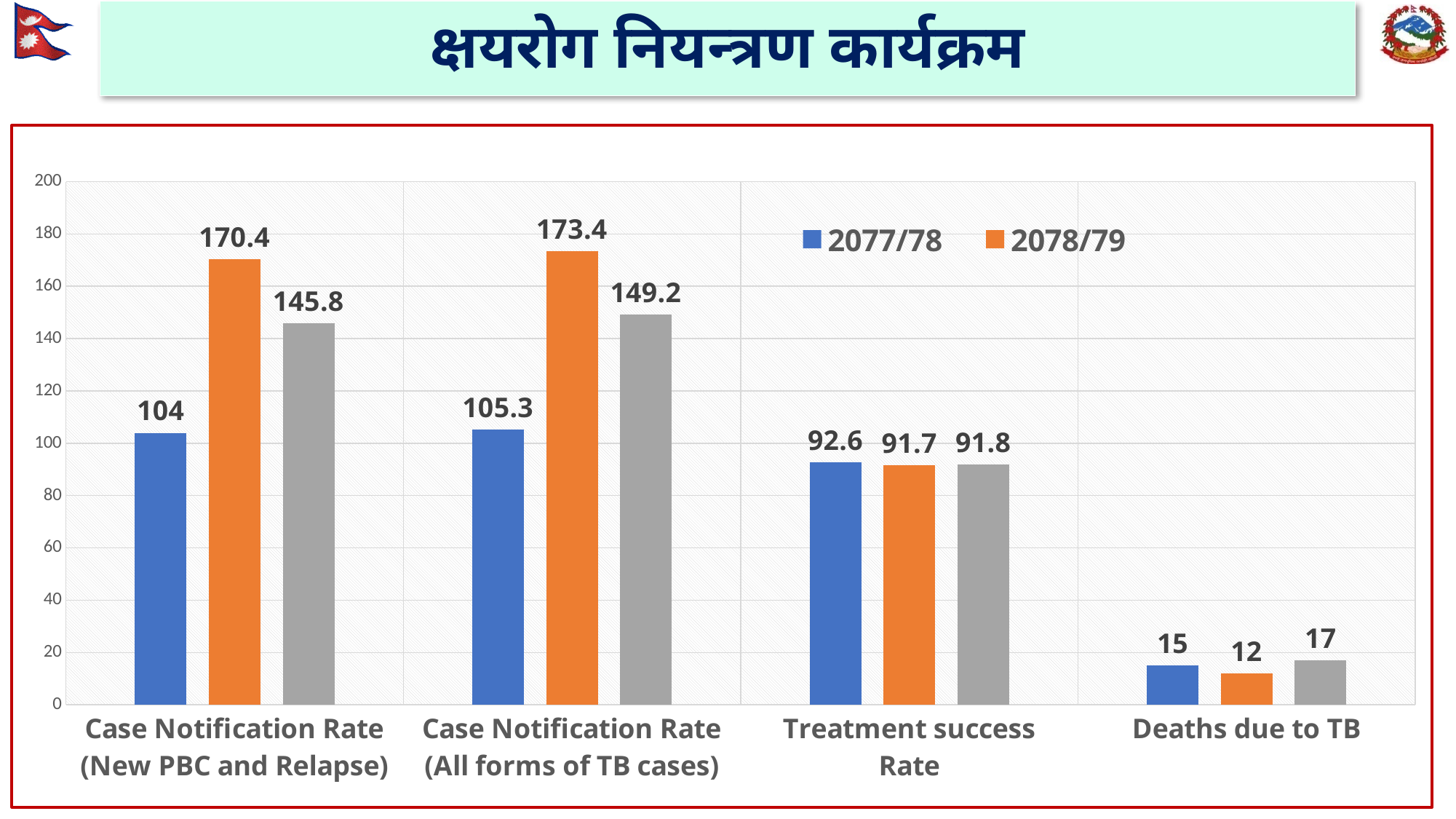
Which category has the lowest value for the 2077/78 series? Deaths due to TB What is the value for 2078/79 for Deaths due to TB? 12 How many series does the chart's legend list? 2 Which category has the highest value for the 2078/79 series? Case Notification Rate (All forms of TB cases) What is the value for 2077/78 for Treatment success Rate? 92.6 What kind of chart is shown on the slide? bar chart For Deaths due to TB, which is larger: the 2077/78 value or the 2078/79 value? 2077/78 What is the value for 2077/78 for Case Notification Rate (New PBC and Relapse)? 104 What is the value for 2078/79 for Case Notification Rate (All forms of TB cases)? 173.4 How many categories are shown along the x axis of the chart? 4 Which series is shown in orange in the chart's legend? 2078/79 What is the difference between the 2078/79 and 2077/78 values for Case Notification Rate (New PBC and Relapse)? 66.4